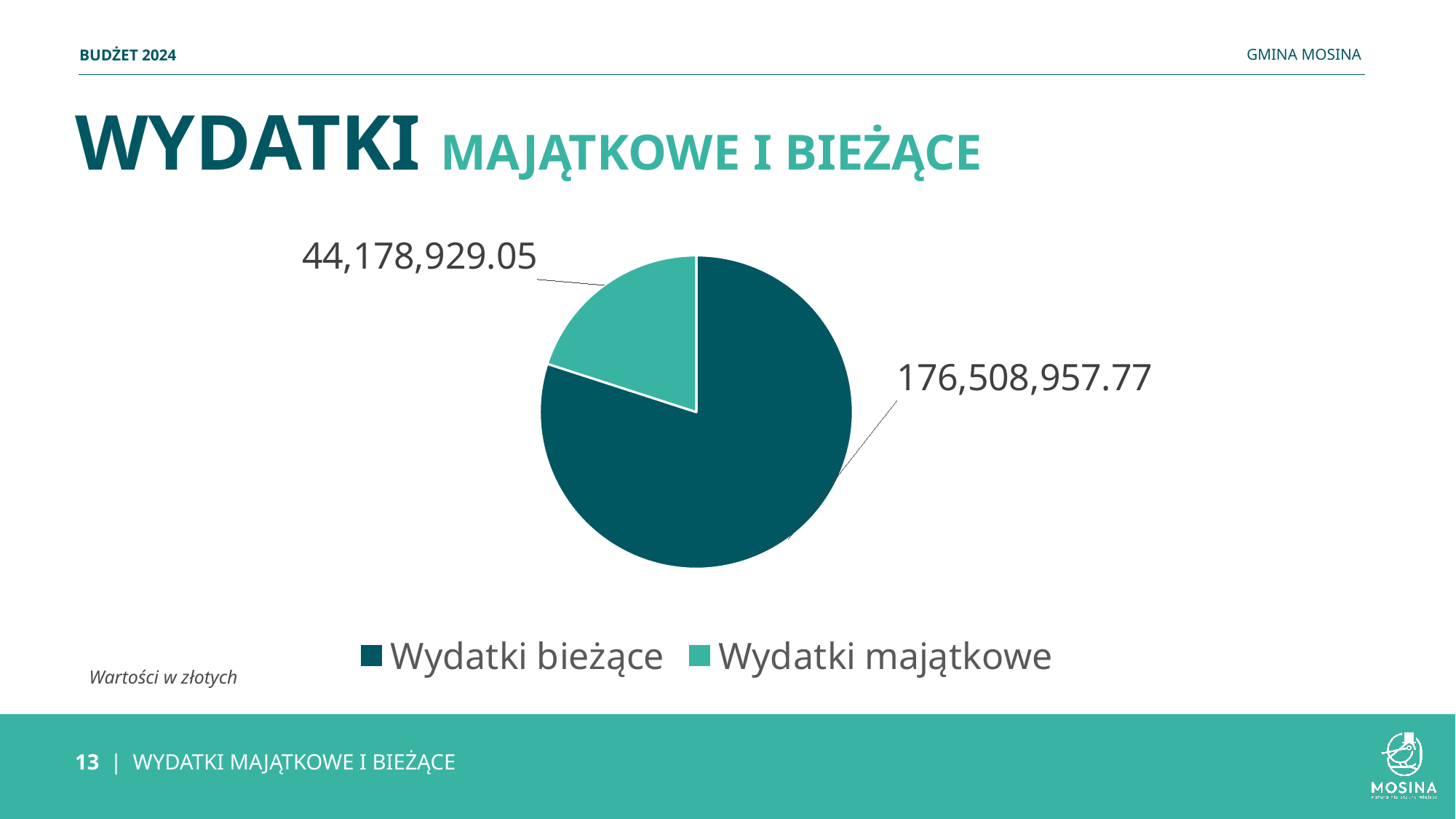
What is the value for Wydatki majątkowe? 44,178,929.05 How many entries does the legend list? 2 What is the value for Wydatki bieżące? 176,508,957.77 What is the total of the two slices in the pie chart? 220,687,886.82 Which category has the smallest slice of the pie? Wydatki majątkowe What type of chart is shown on the slide? Pie chart How many slices does the pie chart have? 2 What share of the pie does Wydatki bieżące represent, rounded to the nearest whole percent? 80% Which is larger, Wydatki bieżące or Wydatki majątkowe? Wydatki bieżące What colour is the Wydatki majątkowe slice? Light teal (green) Which category has the largest slice of the pie? Wydatki bieżące What is the difference between Wydatki bieżące and Wydatki majątkowe? 132,330,028.72